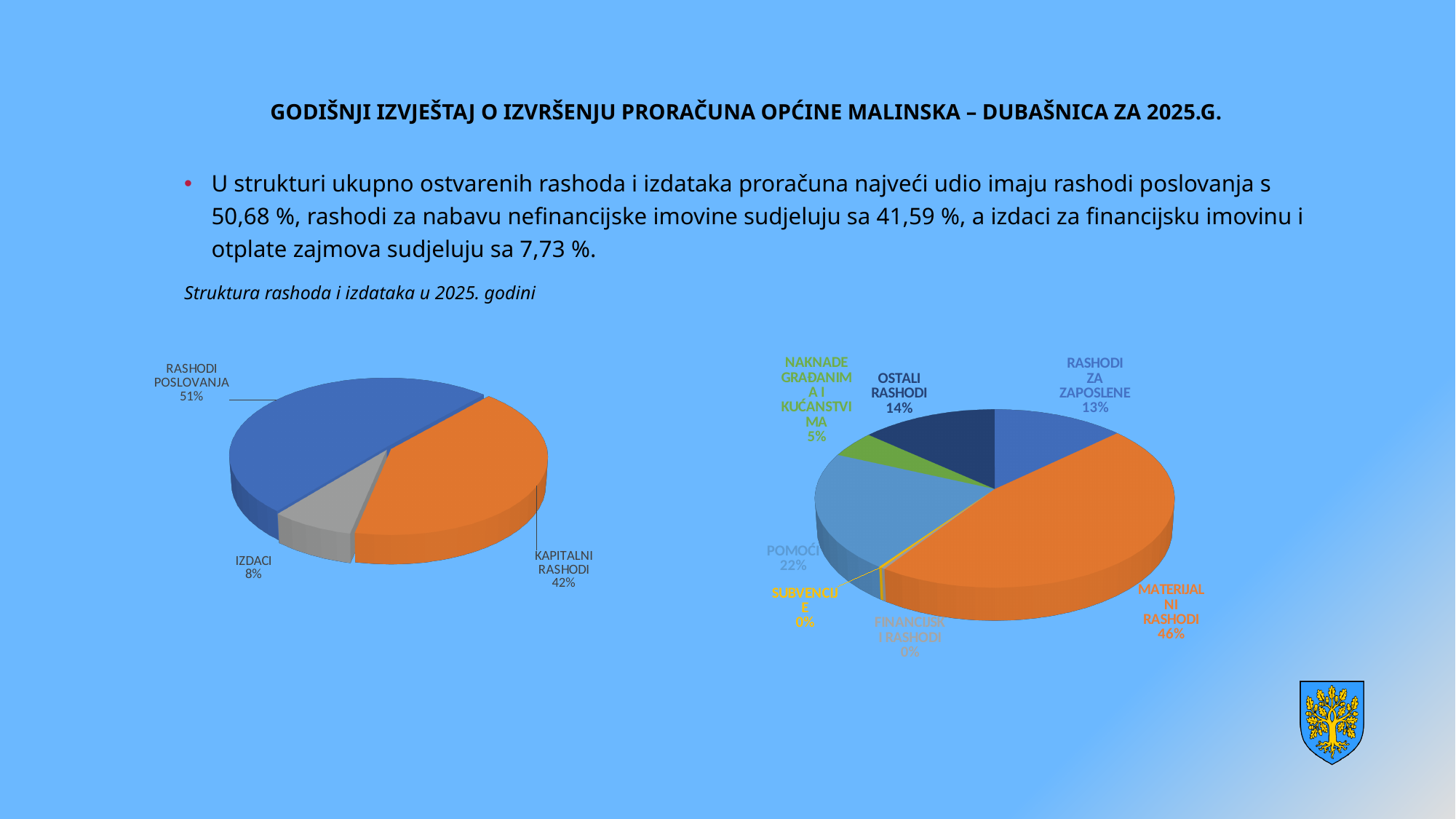
In the left pie chart, which category has the smallest share? IZDACI In the left pie chart, what share does KAPITALNI RASHODI have? 42% In the right pie chart, which category has the largest share? MATERIJALNI RASHODI In the left pie chart, what share does RASHODI POSLOVANJA have? 51% In the right pie chart, what is the difference in percentage points between POMOĆI and RASHODI ZA ZAPOSLENE? 9 In the right pie chart, which is larger, OSTALI RASHODI or NAKNADE GRAĐANIMA I KUĆANSTVIMA? OSTALI RASHODI In the right pie chart, what share does MATERIJALNI RASHODI have? 46% What kind of chart is the left chart on the slide? pie chart How many slices does the left pie chart have? 3